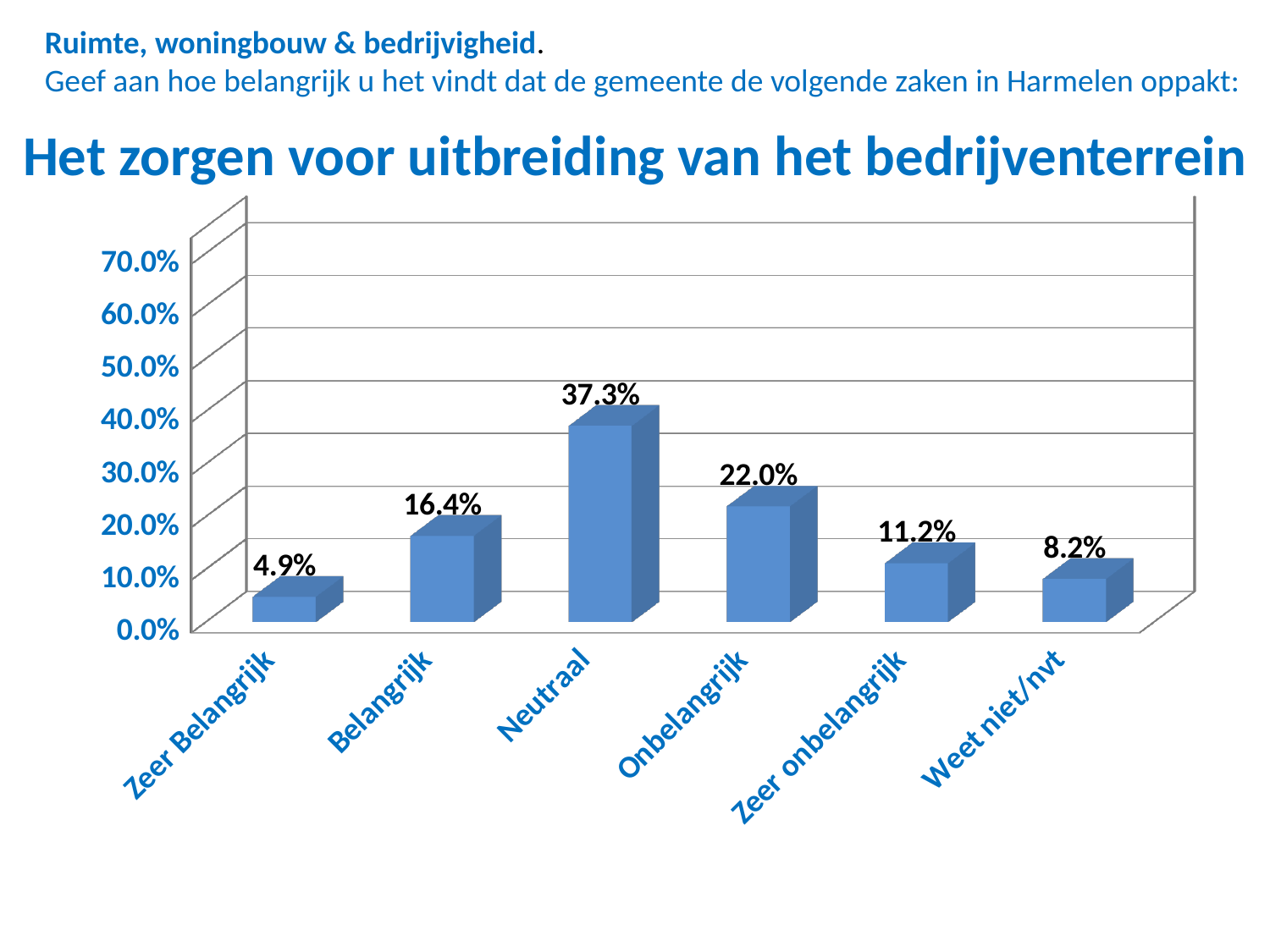
What is the value for Weet niet/nvt? 8.2% What is the difference between the values for Belangrijk and Zeer onbelangrijk? 5.2% What kind of chart is shown on the slide? Bar chart What is the value for Onbelangrijk? 22.0% Which category has the lowest value? Zeer Belangrijk Which category has the highest value? Neutraal What is the value for Zeer Belangrijk? 4.9% Which is larger, the value for Belangrijk or the value for Zeer onbelangrijk? Belangrijk What is the difference between the values for Neutraal and Onbelangrijk? 15.3% What is the title of the chart? Het zorgen voor uitbreiding van het bedrijventerrein What is the value for Neutraal? 37.3% How many categories are shown on the x axis? 6